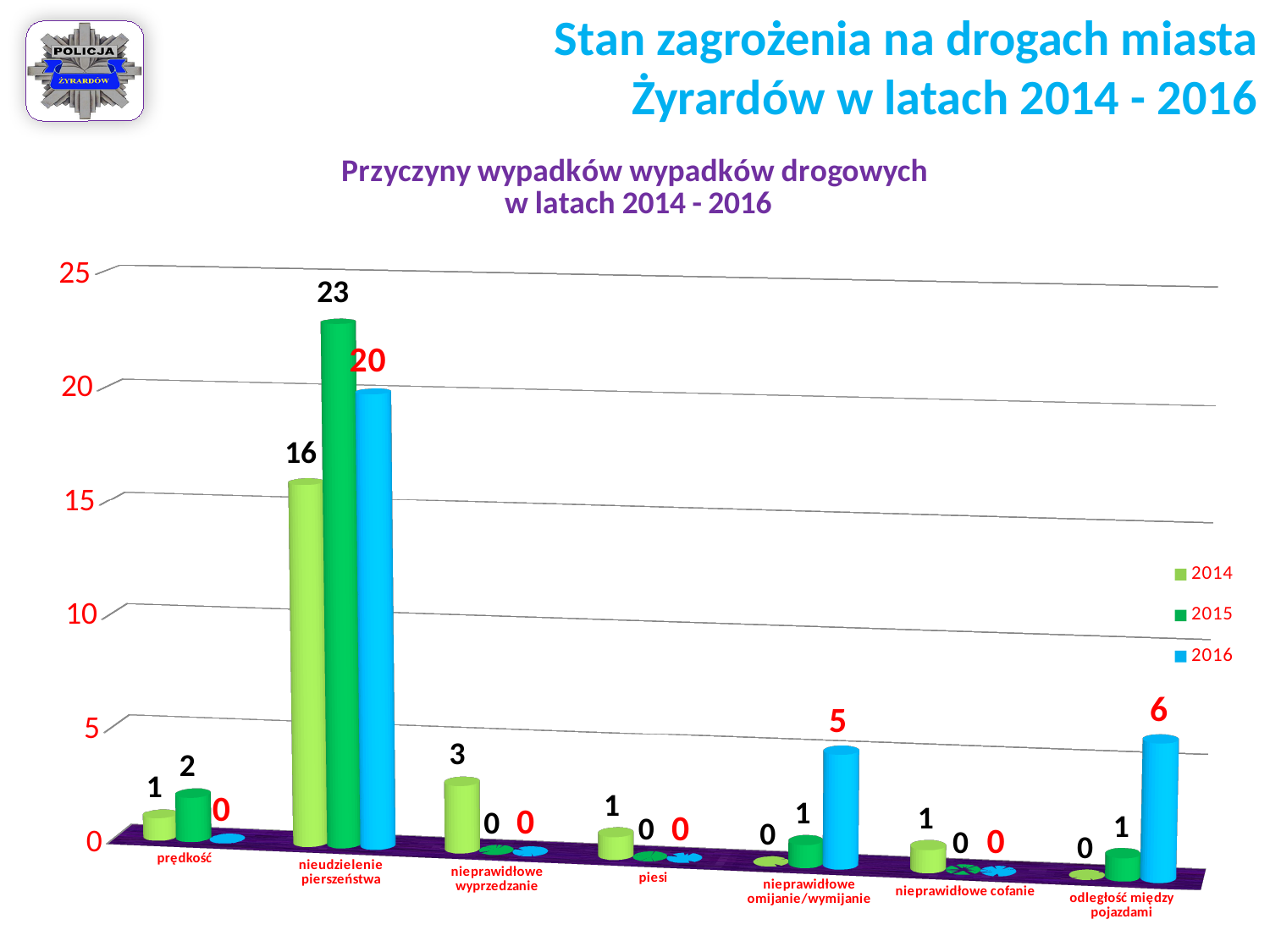
Which is larger in the 'prędkość' category: the 2014 value or the 2015 value? 2015 Which series is shown in blue in the legend? 2016 What is the difference between the 2015 and 2014 values in the 'nieudzielenie pierszeństwa' category? 7 How many series does the legend list? 3 What kind of chart is shown on the slide? bar chart Which category has the highest value for the 2014 series? nieudzielenie pierszeństwa What is the value for 2015 in the 'nieudzielenie pierszeństwa' category? 23 What is the value for 2016 in the 'nieprawidłowe omijanie/wymijanie' category? 5 What is the value for 2014 in the 'nieprawidłowe wyprzedzanie' category? 3 How many categories are shown on the x axis? 7 What is the title of the chart? Przyczyny wypadków wypadków drogowych w latach 2014 - 2016 What is the value for 2016 in the 'odległość między pojazdami' category? 6